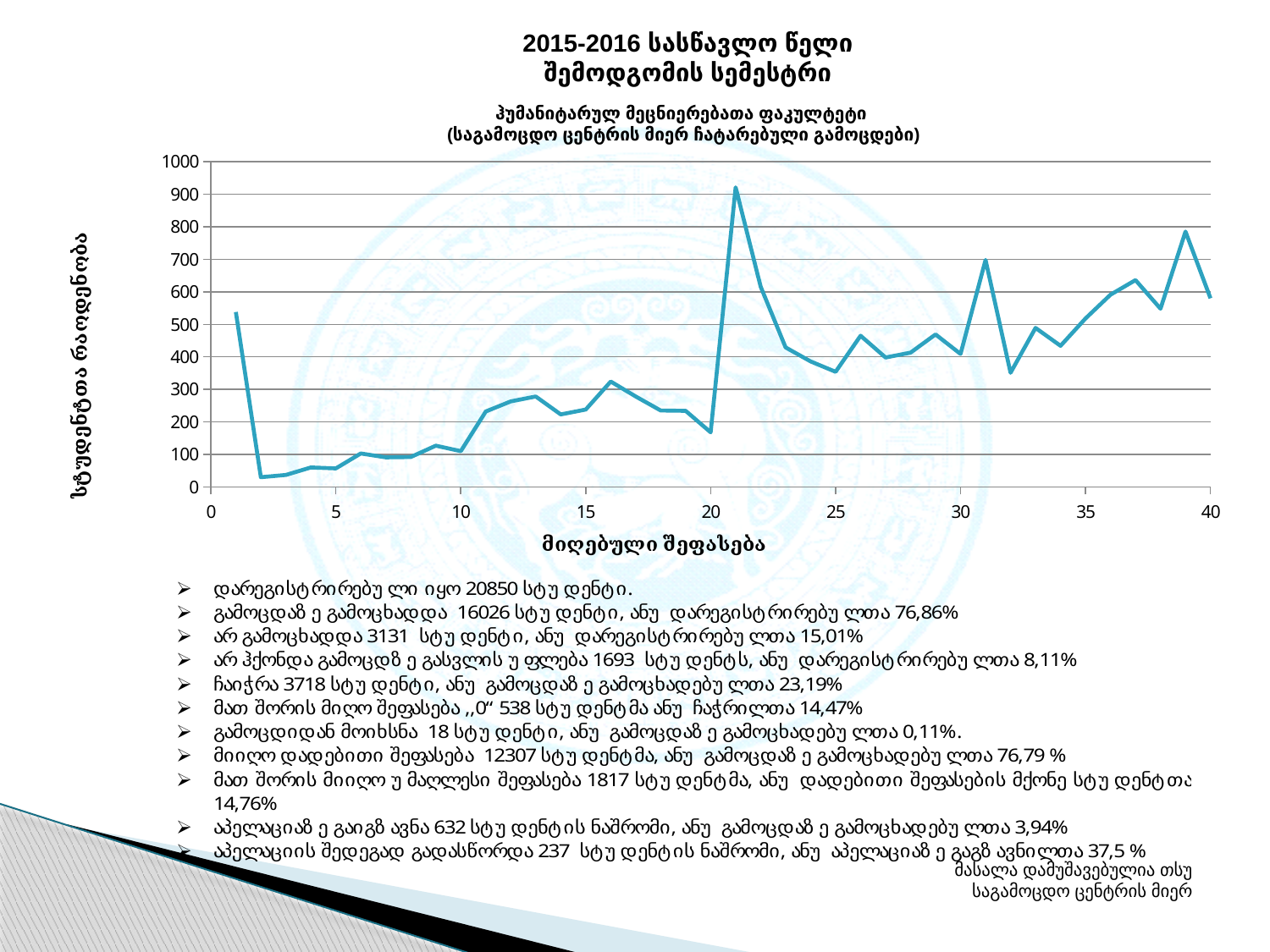
Is the value at score 1 greater or less than 500? greater What is the title of the y axis? სტუდენტთა რაოდენობა Which is larger, the value at score 1 or the value at score 20? score 1 At which score on the x axis does the line reach its highest value? 21 Is the value at score 20 greater or less than 200? less What kind of chart is shown on the slide? line chart Which is larger, the value at score 21 or the value at score 39? score 21 Is the value at score 21 greater or less than 800? greater Do the values rise or fall between score 21 and score 25? fall